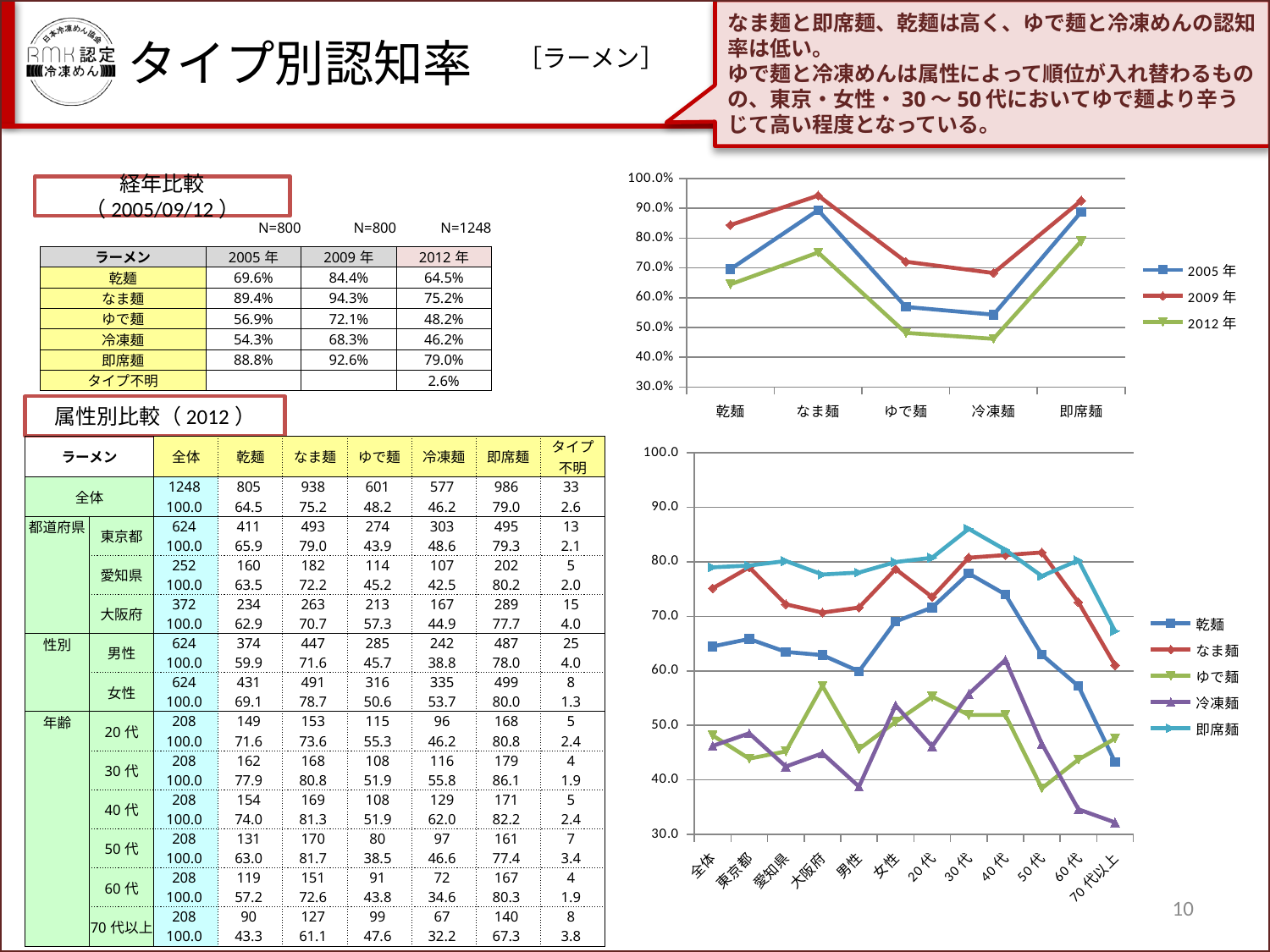
In the top chart, which category has the lowest value in the 2005年 series? 冷凍麺 In the top chart, what is the value for なま麺 in the 2009年 series? 94.3% What type of chart is the top chart on the right of the slide? Line chart In the top chart, which category has the highest value in the 2012年 series? 即席麺 In the bottom chart, is the 冷凍麺 value for 70代以上 greater or less than 40.0? less How many categories are shown on the x axis of the bottom chart? 12 In the top chart, is the 2012年 value for ゆで麺 greater or less than 50.0%? less In the bottom chart, at which category does the 即席麺 series reach its highest value? 30代 How many series does the legend of the top chart list? 3 In the top chart, what is the difference between the 2009年 and 2012年 values for なま麺? 19.1% How many categories are shown on the x axis of the top chart? 5 How many series does the legend of the bottom chart list? 5